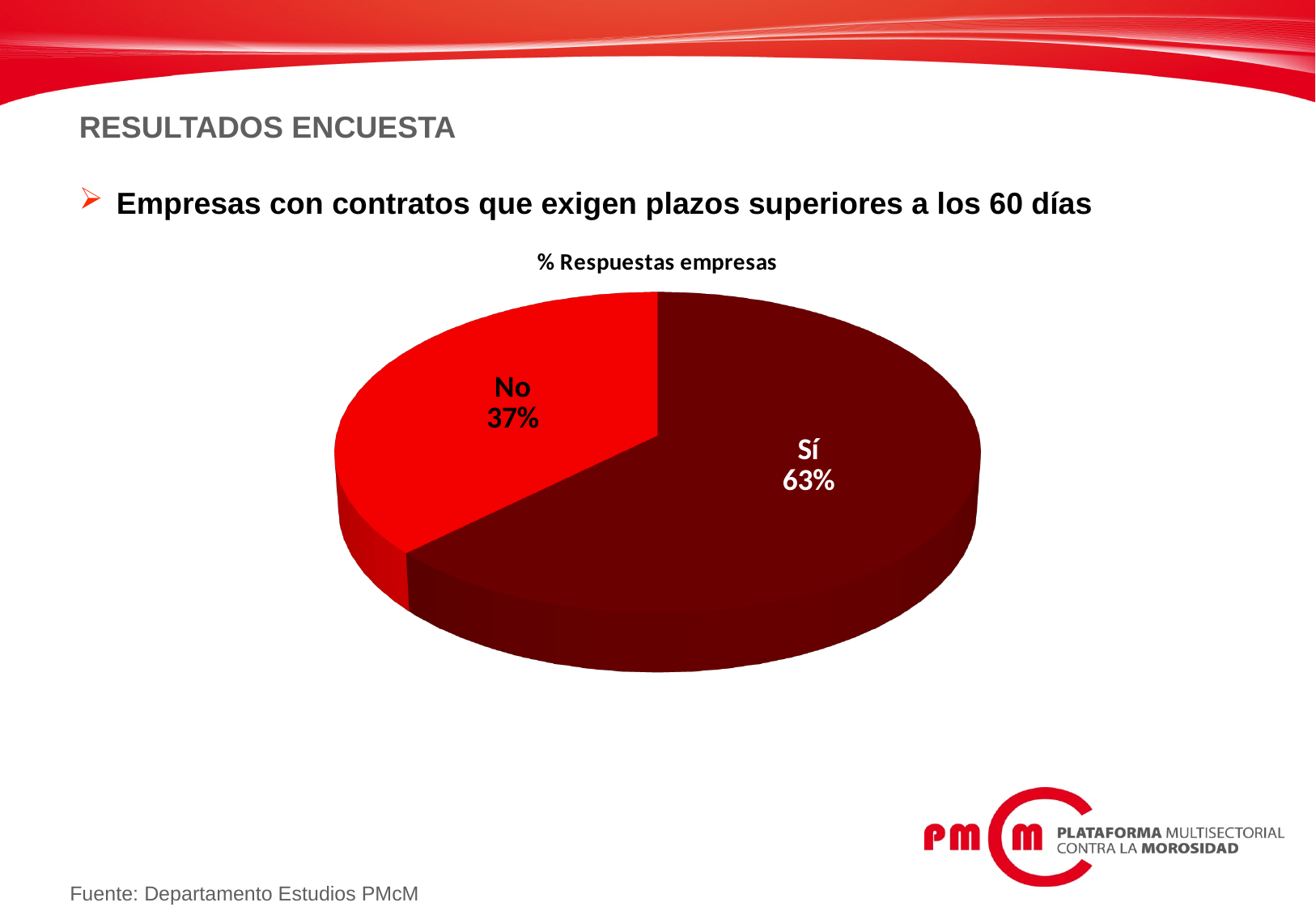
Which response has the largest share of the pie? Sí Which is larger, the share for "Sí" or the share for "No"? Sí What percentage of companies answered "No"? 37% What share of the pie does the "No" slice represent? 37% What is the title of the chart? % Respuestas empresas Which response has the smallest share of the pie? No Which slice is shown in the darker red colour? Sí What percentage of companies answered "Sí"? 63% How many slices does the pie chart have? 2 What kind of chart is shown on the slide? Pie chart What is the difference in percentage points between the "Sí" and "No" responses? 26